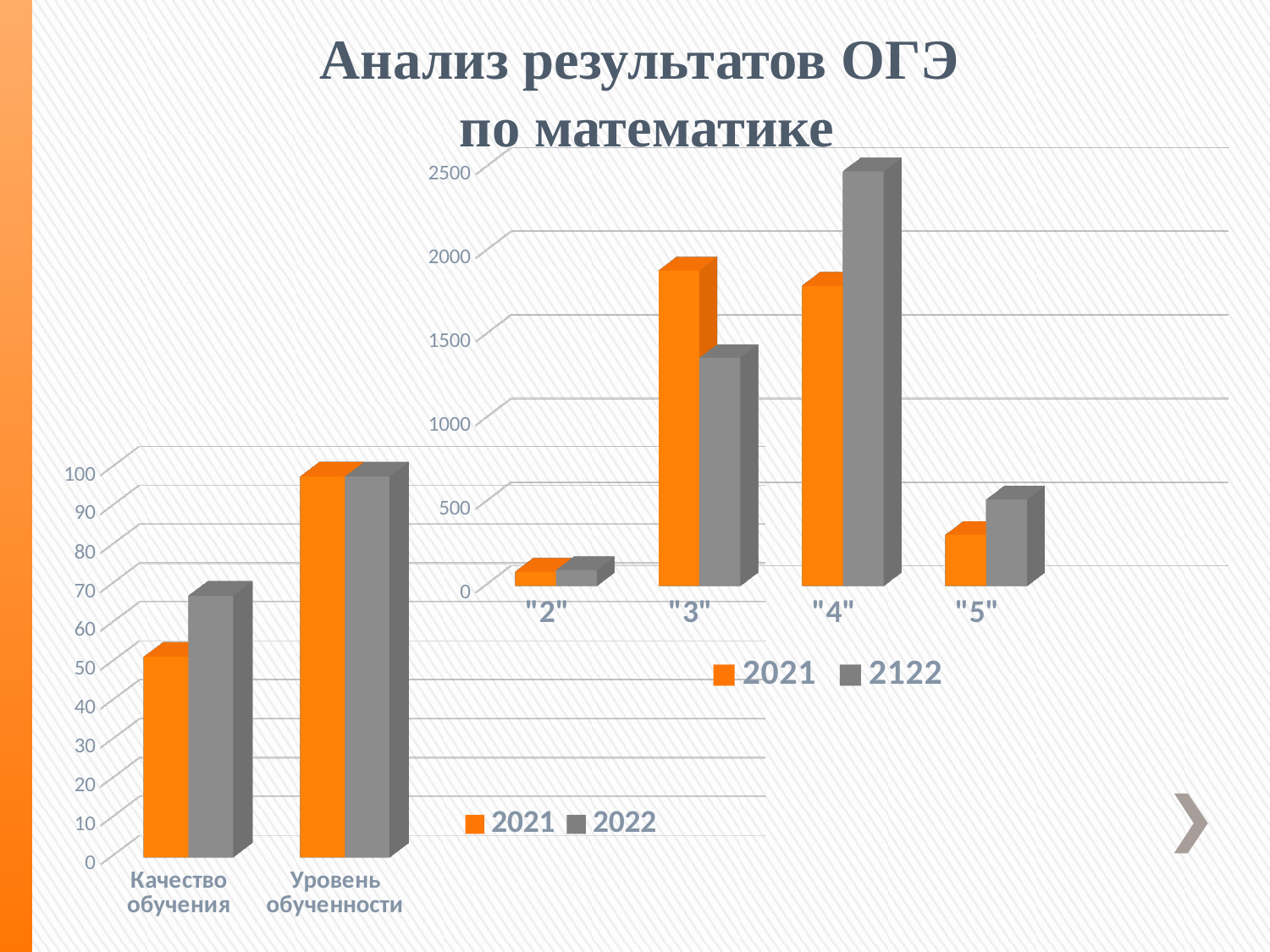
On the left chart, is the 2021 value for Качество обучения greater or less than 60? less On the right chart, which category has the lowest value for the 2021 series? "2" What kind of chart is the left chart? Bar chart On the left chart, how many series does the legend list? 2 On the left chart, is the 2022 value for Качество обучения greater or less than 60? greater On the right chart, which series has the larger value for "3", 2021 or 2122? 2021 On the right chart, how many categories are shown on the x axis? 4 On the left chart, how many categories are shown on the x axis? 2 On the right chart, which category has the highest value for the 2122 series? "4" On the right chart, is the 2021 value for "3" greater or less than 1500? greater On the left chart, which year has the larger value for Качество обучения, 2021 or 2022? 2022 On the right chart, what are the two legend entries? 2021 and 2122